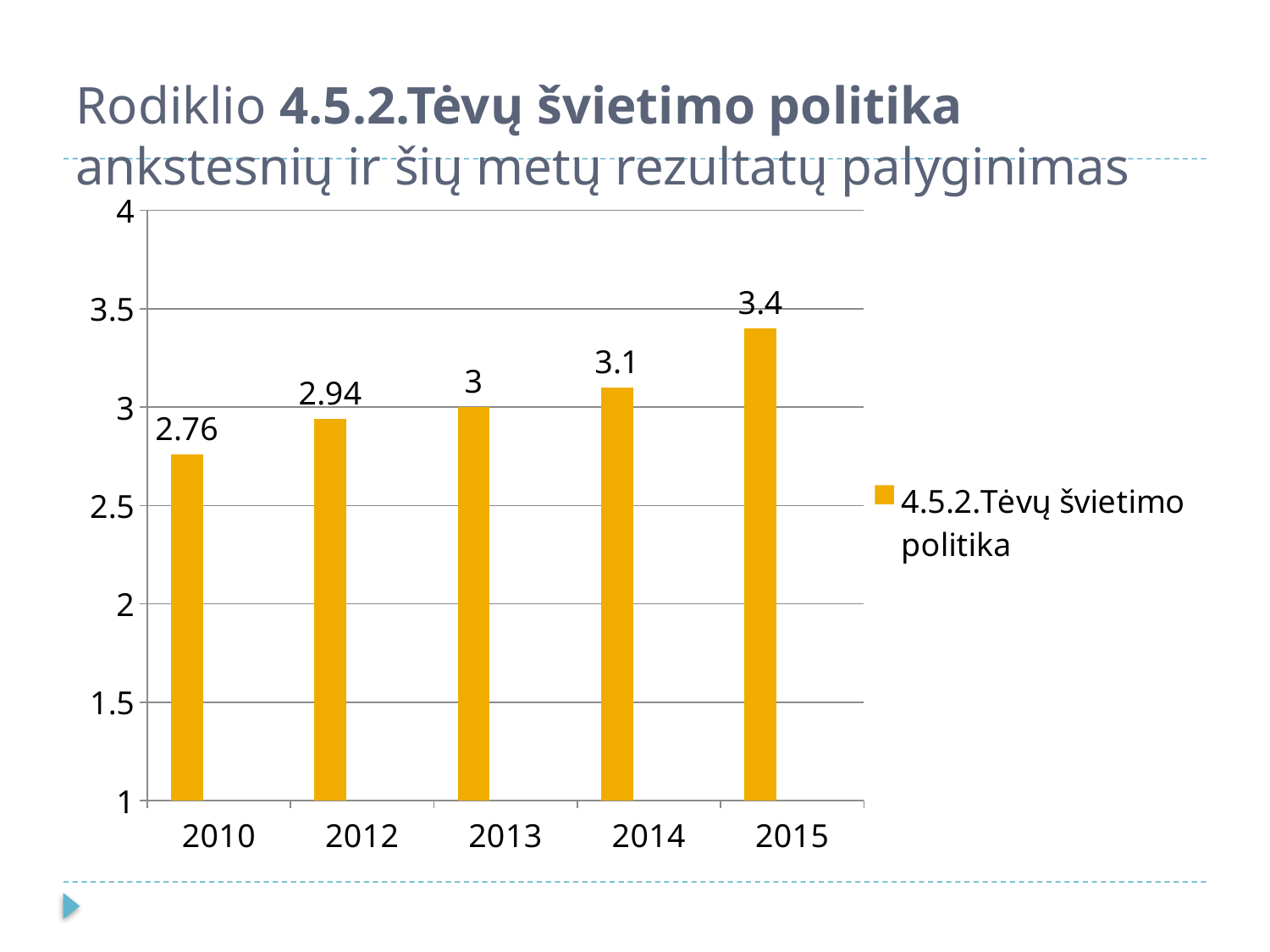
What is the value for 2014? 3.1 Which year has the highest value? 2015 Which is larger, the value for 2013 or the value for 2012? 2013 Which year has the lowest value? 2010 What is the difference between the values for 2015 and 2010? 0.64 What is the value for 2010? 2.76 How many years are shown on the x axis? 5 Do the values rise or fall from 2010 to 2015? Rise What is the value for 2015? 3.4 What kind of chart is shown on the slide? Bar chart How many series does the legend list? 1 What is the value for 2012? 2.94